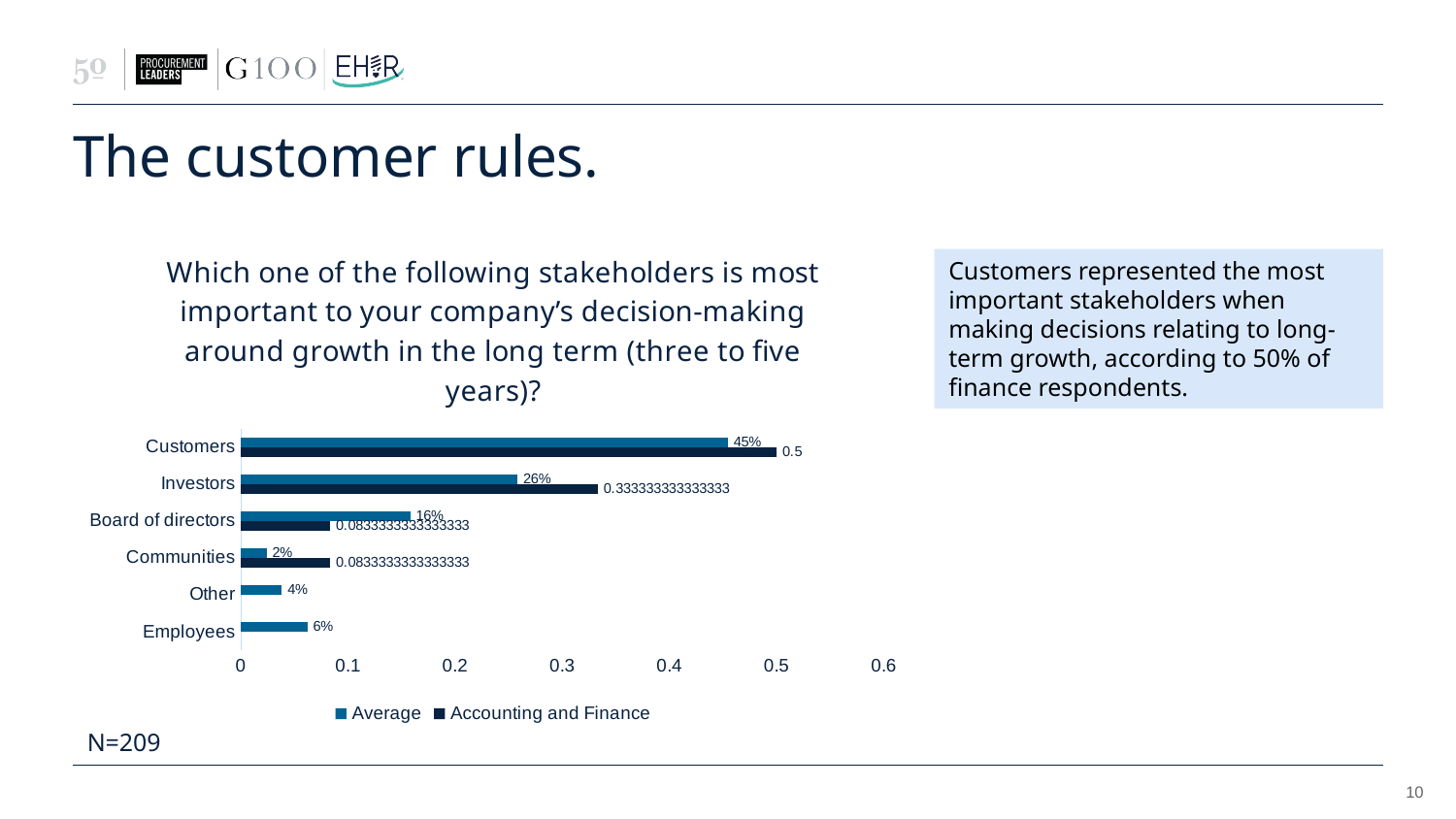
What is the Average value for Customers? 45% What is the difference between the Average values for Customers and Investors? 19% What is the Accounting and Finance value for Investors? 0.333333333333333 Which has a larger Average value, Board of directors or Other? Board of directors How many series does the legend list? 2 What kind of chart is shown on the slide? Bar chart What is the Average value for Investors? 26% Which stakeholder has the lowest Average value? Communities What is the Accounting and Finance value for Customers? 0.5 How many stakeholder categories are shown on the chart? 6 What is the Average value for Employees? 6% Which stakeholder has the highest Average value? Customers